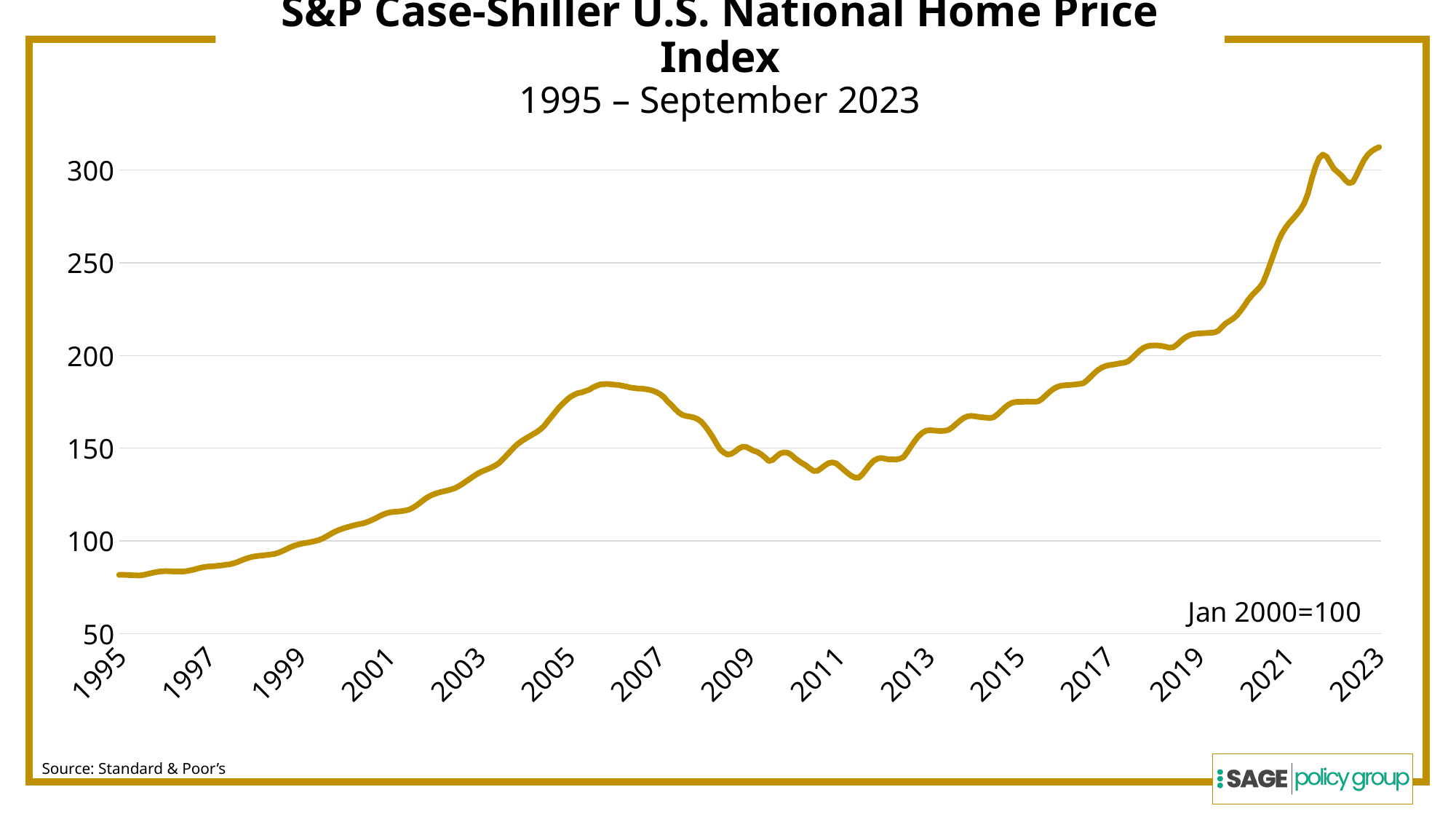
Is the value of the index at the start of 2019 greater or less than 200? greater Is the value of the index at the start of 2011 greater or less than 150? less What base period is the index set to 100, according to the note on the chart? Jan 2000 Is the value of the index at the start of 2017 greater or less than 200? less Does the index rise or fall between 2007 and 2011? fall What kind of chart is shown on the slide? line chart What is the title of the chart? S&P Case-Shiller U.S. National Home Price Index In which year shown on the x axis is the index at its lowest? 1995 Does the index rise or fall between 2012 and 2022? rise